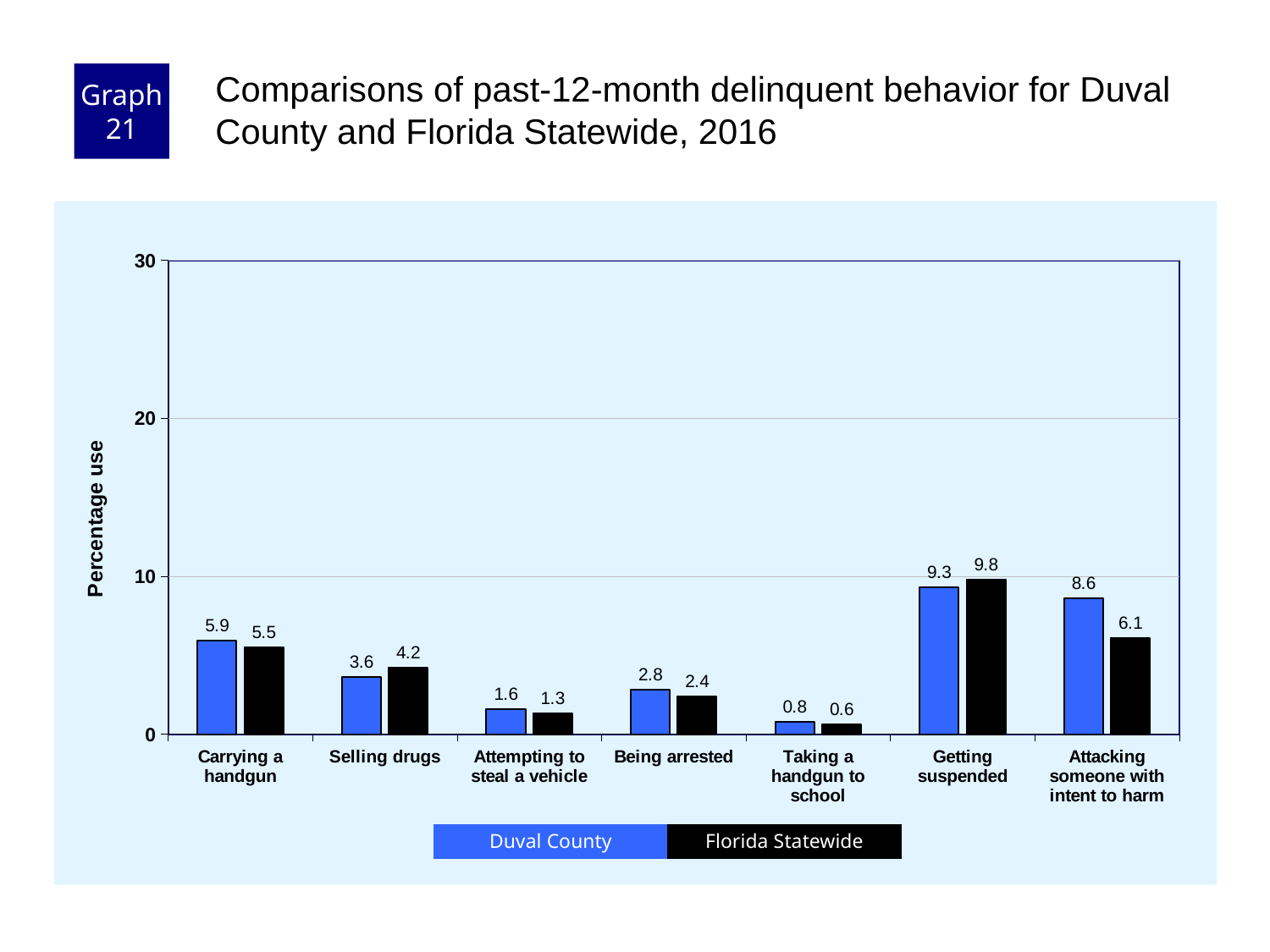
What is the Duval County value for Getting suspended? 9.3 Which category has the lowest Duval County value? Taking a handgun to school What is the Florida Statewide value for Attacking someone with intent to harm? 6.1 What kind of chart is shown on the slide? bar chart How many categories are shown on the x axis? 7 What is the label of the y axis? Percentage use What is the Duval County value for Taking a handgun to school? 0.8 Is the Florida Statewide value for Getting suspended greater or less than 10? less What is the difference between the Duval County and Florida Statewide values for Attacking someone with intent to harm? 2.5 Which is larger for Selling drugs: the Duval County value or the Florida Statewide value? Florida Statewide How many series does the legend list? 2 Which category has the highest Florida Statewide value? Getting suspended